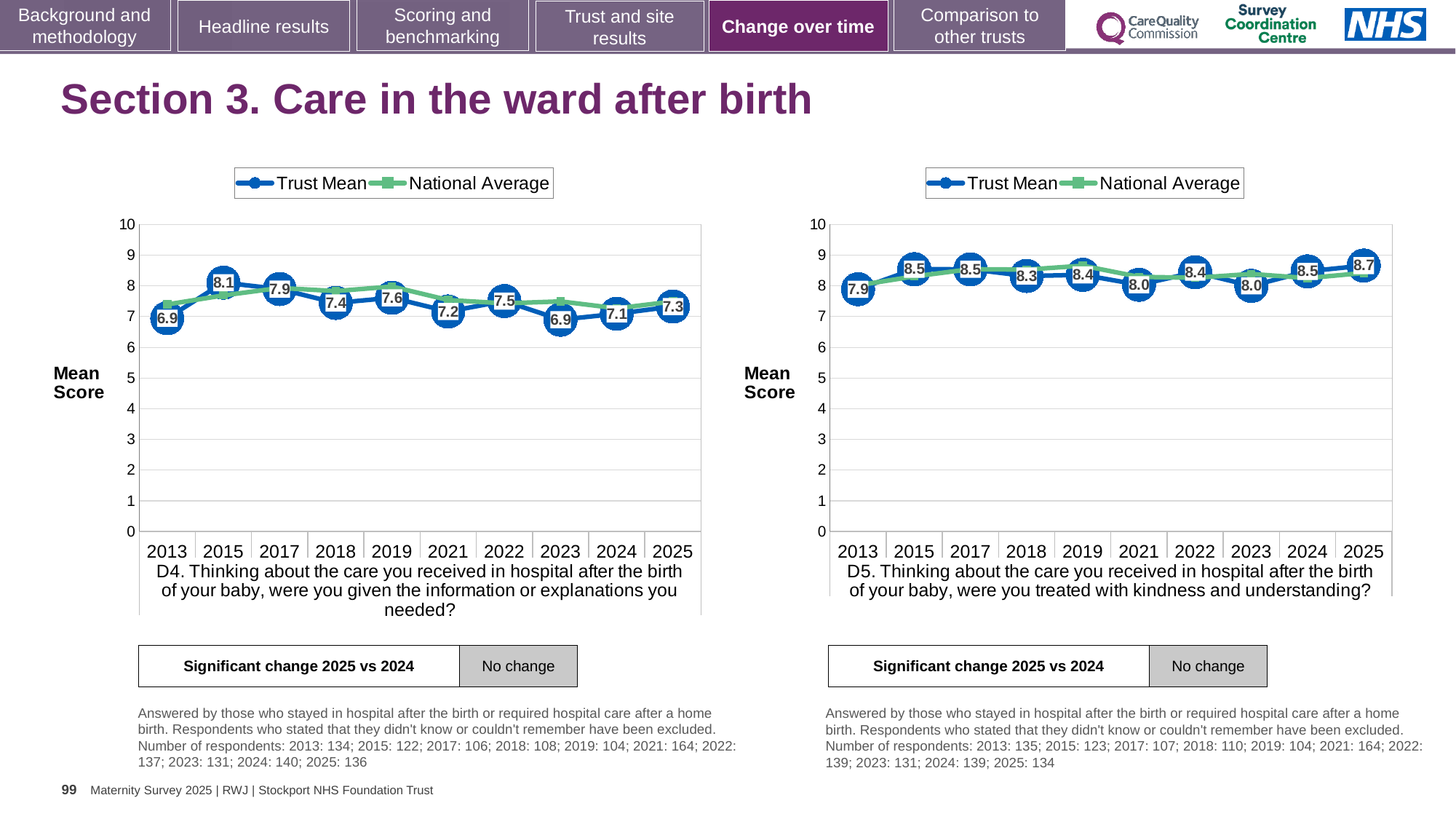
In the D5 chart on the right, is the Trust Mean score for 2025 greater or less than 8? greater In the D5 chart on the right, what is the difference between the Trust Mean scores for 2025 and 2021? 0.7 In the D5 chart on the right, which year has the highest Trust Mean score? 2025 How many years are plotted on the x axis of the D4 chart on the left? 10 How many series does the legend of the D5 chart on the right list? 2 In the D4 chart on the left, is the Trust Mean score higher in 2019 or in 2021? 2019 In the D4 chart on the left, what is the difference between the Trust Mean scores for 2015 and 2013? 1.2 In the D5 chart on the right, does the Trust Mean score rise or fall from 2023 to 2025? Rise In the D4 chart on the left, which year has the highest Trust Mean score? 2015 In the D5 chart on the right, what is the Trust Mean score for 2013? 7.9 What kind of chart is the D4 chart on the left? Line chart In the D4 chart on the left, what is the Trust Mean score for 2025? 7.3